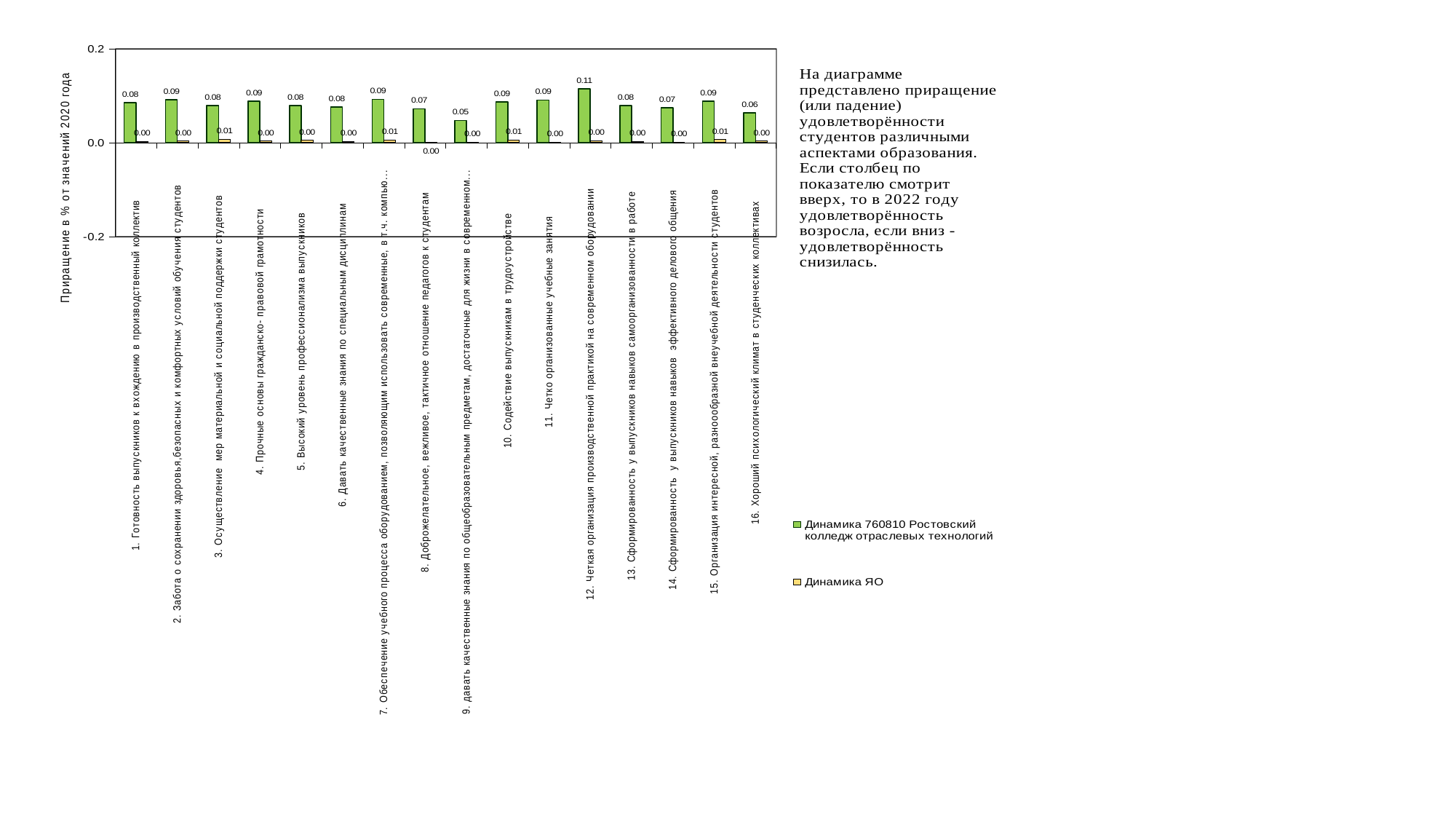
Which category has the highest value for the 'Динамика 760810 Ростовский колледж отраслевых технологий' series? 12. Четкая организация производственной практикой на современном оборудовании How many categories are plotted along the x axis? 16 What kind of chart is shown on the slide? bar chart Which category has the lowest value for the 'Динамика 760810 Ростовский колледж отраслевых технологий' series? 9. давать качественные знания по общеобразовательным предметам, достаточные для жизни в современном… What is the value of the 'Динамика ЯО' series for category '3. Осуществление мер материальной и социальной поддержки студентов'? 0.01 How many series does the legend list? 2 What colour are the bars for the 'Динамика ЯО' series? yellow What is the value of the 'Динамика 760810 Ростовский колледж отраслевых технологий' series for category '9. давать качественные знания по общеобразовательным предметам, достаточные для жизни в современном…'? 0.05 What is the label of the vertical axis? Приращение в % от значений 2020 года What is the value of the 'Динамика 760810 Ростовский колледж отраслевых технологий' series for category '12. Четкая организация производственной практикой на современном оборудовании'? 0.11 For category '8. Доброжелательное, вежливое, тактичное отношение педагогов к студентам', which series has the larger value: 'Динамика 760810 Ростовский колледж отраслевых технологий' or 'Динамика ЯО'? Динамика 760810 Ростовский колледж отраслевых технологий What is the difference between the 'Динамика 760810 Ростовский колледж отраслевых технологий' values for category 12 (Четкая организация производственной практикой) and category 16 (Хороший психологический климат в студенческих коллективах)? 0.05